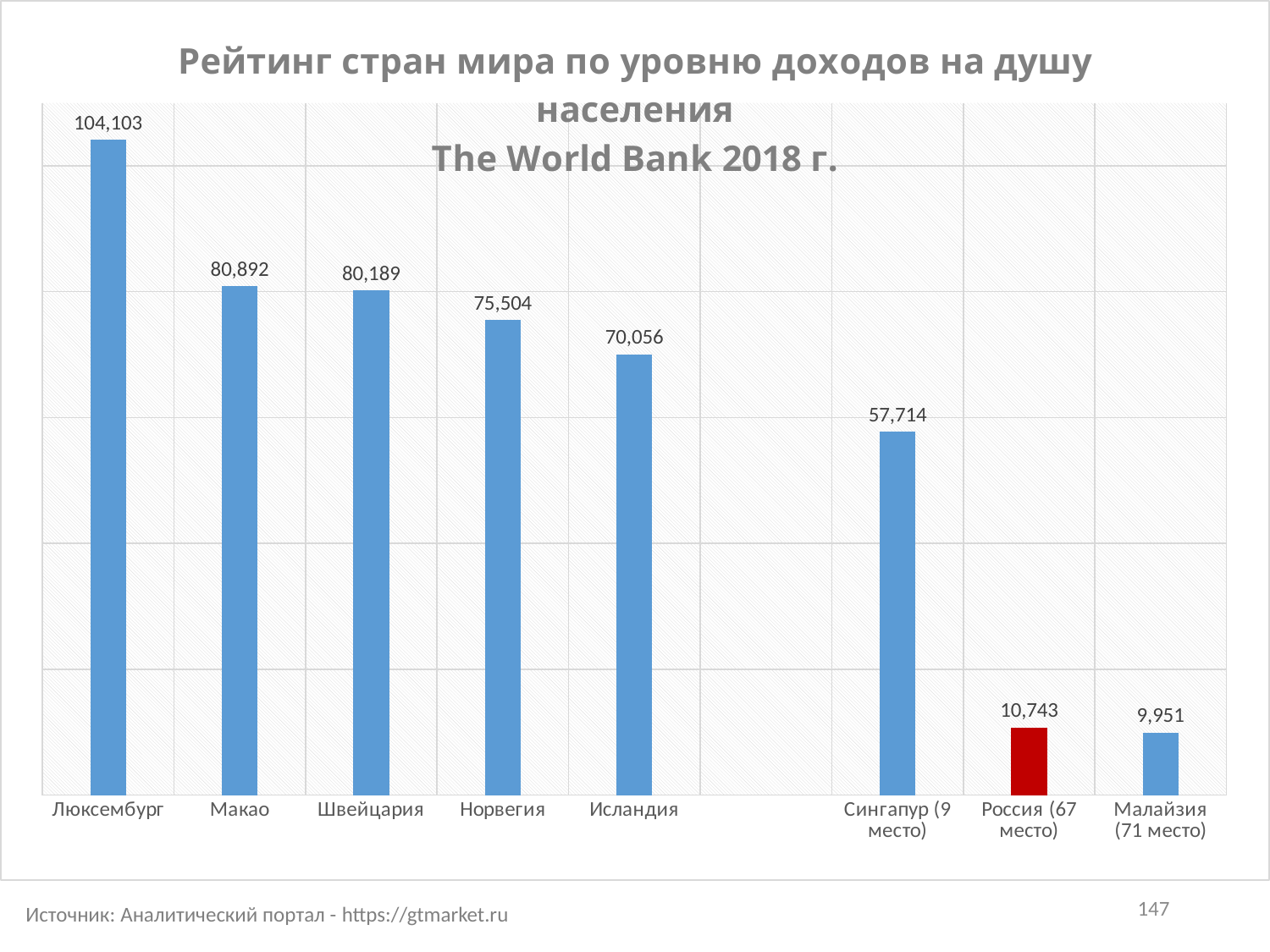
How many countries are shown on the chart? 8 What is the difference between the values for Россия (67 место) and Малайзия (71 место)? 792 What is the value shown for Сингапур (9 место)? 57,714 What is the difference between the values for Люксембург and Макао? 23,211 What is the value shown for Россия (67 место)? 10,743 Which country has the highest value on the chart? Люксембург Which bar is coloured red instead of blue? Россия (67 место) What is the value shown for Люксембург? 104,103 What kind of chart is shown on the slide? Bar chart Which has a larger value, Исландия or Сингапур (9 место)? Исландия Which country has the lowest value on the chart? Малайзия (71 место) What is the value shown for Норвегия? 75,504